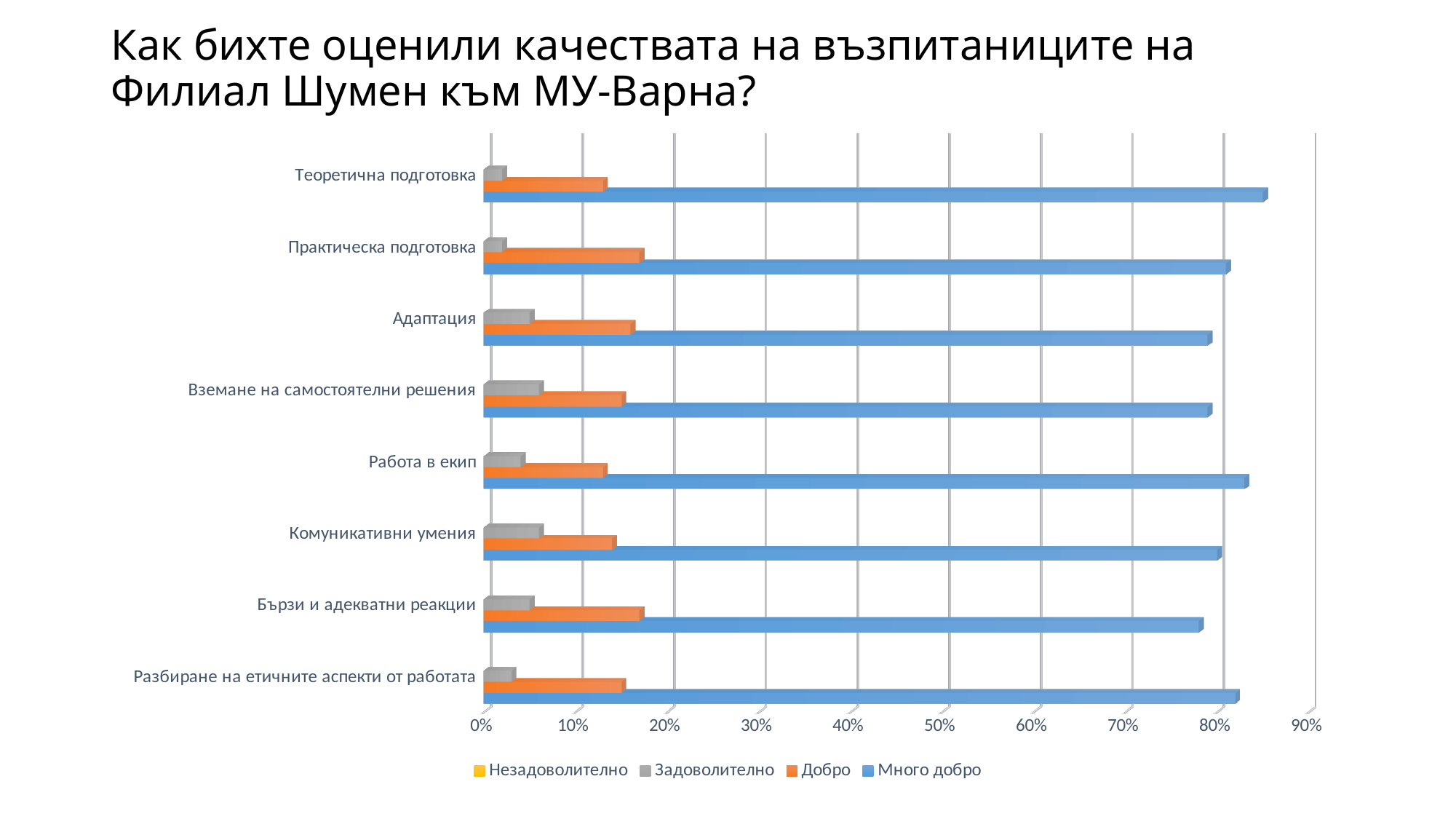
Is the value of Добро for Практическа подготовка greater or less than 20%? less Is the value of Много добро for Теоретична подготовка greater or less than 80%? greater How many series does the legend list? 4 How many categories are shown on the chart? 8 Which category has the highest value for the series Много добро? Теоретична подготовка Which colour represents the series Много добро in the legend? blue Is the value of Задоволително for Теоретична подготовка greater or less than 10%? less For the series Задоволително, which is larger: Вземане на самостоятелни решения or Теоретична подготовка? Вземане на самостоятелни решения For the series Много добро, which is larger: Теоретична подготовка or Адаптация? Теоретична подготовка What kind of chart is shown on the slide? bar chart For the series Добро, which is larger: Практическа подготовка or Теоретична подготовка? Практическа подготовка